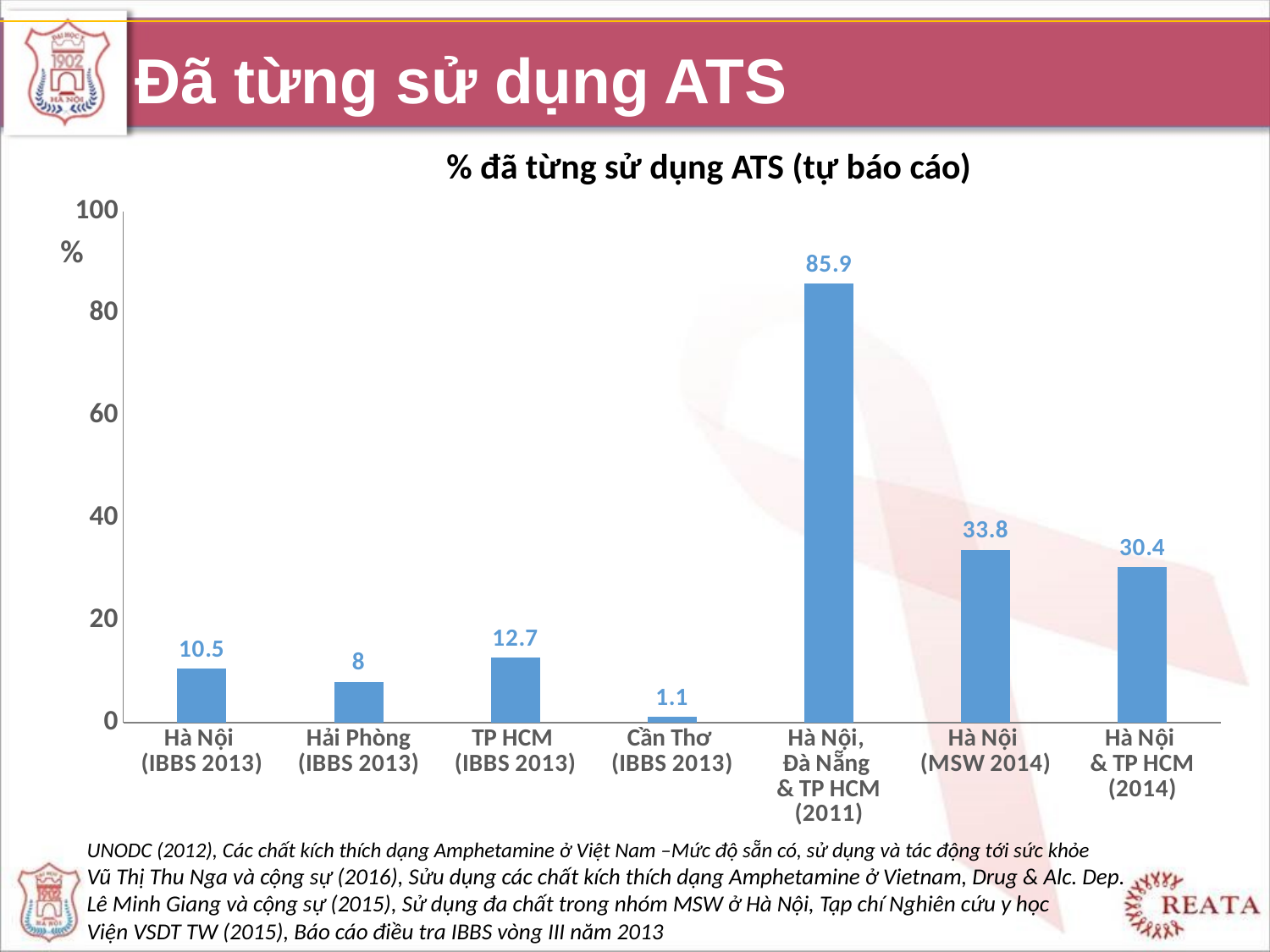
What is the value for Cần Thơ (IBBS 2013)? 1.1 How many categories are shown on the x axis? 7 What is the title of the chart? % đã từng sử dụng ATS (tự báo cáo) What is the value for Hà Nội & TP HCM (2014)? 30.4 Is the value for Hà Nội, Đà Nẵng & TP HCM (2011) greater or less than 80? greater Which category has the highest value? Hà Nội, Đà Nẵng & TP HCM (2011) What is the difference between the values for TP HCM (IBBS 2013) and Hải Phòng (IBBS 2013)? 4.7 What kind of chart is shown on the slide? bar chart What is the value for Hà Nội (IBBS 2013)? 10.5 Which category has the lowest value? Cần Thơ (IBBS 2013) What is the value for Hà Nội (MSW 2014)? 33.8 Which is larger, the value for Hà Nội (MSW 2014) or the value for Hà Nội & TP HCM (2014)? Hà Nội (MSW 2014)